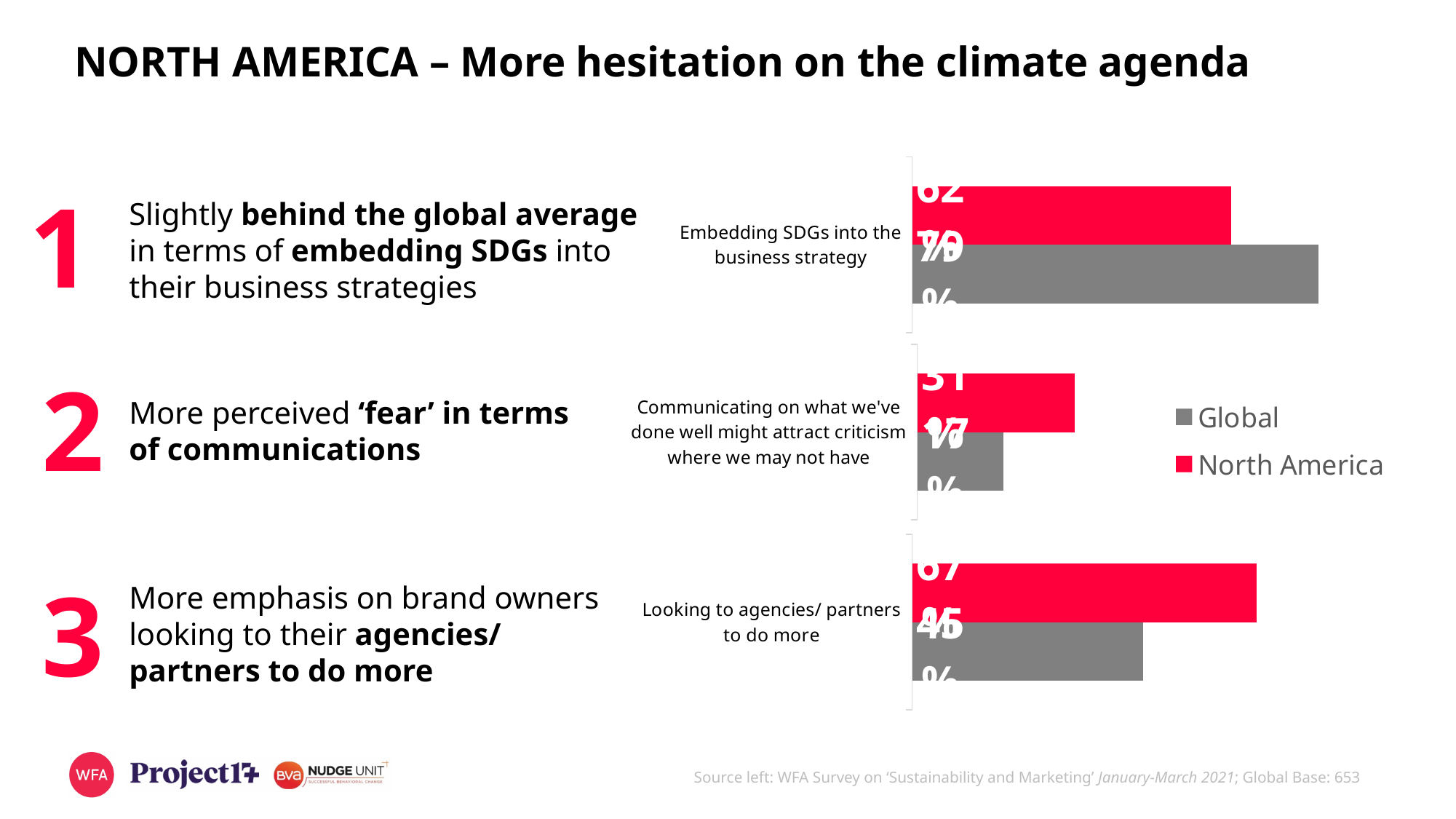
In the 'Communicating on what we've done well might attract criticism where we may not have' chart, which series has the shorter bar? Global How many separate bar charts are shown on the slide? 3 In the 'Embedding SDGs into the business strategy' chart, which series has the longer bar, Global or North America? Global How many series does the legend list? 2 What are the two series named in the legend? Global and North America What kind of chart is used on the slide to show the Global and North America values? Bar chart In the 'Looking to agencies/ partners to do more' chart, which series has the longer bar, Global or North America? North America Which colour represents North America in the charts? Red